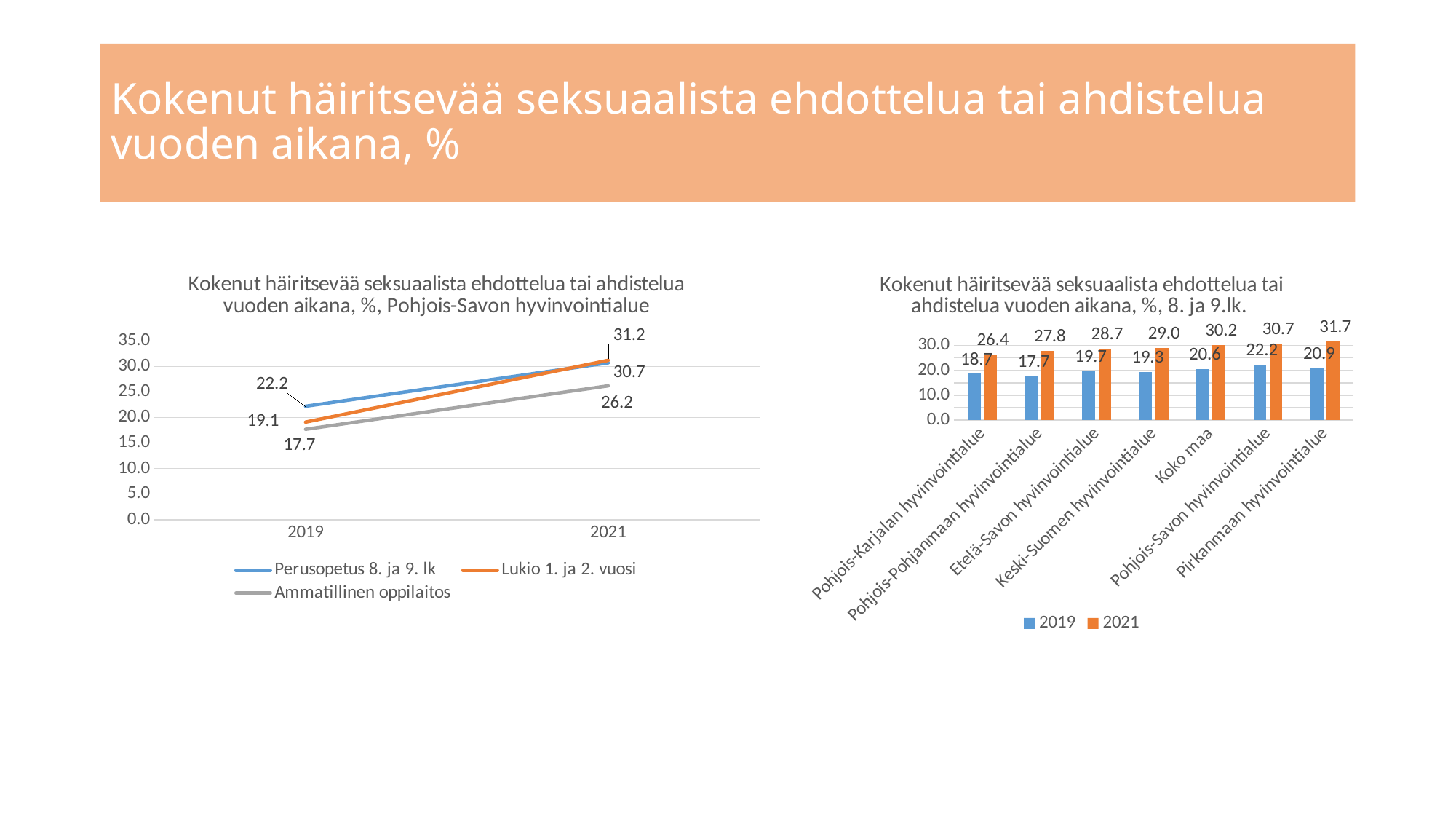
In the right chart (8. ja 9.lk), how many categories are shown on the x axis? 7 In the right chart (8. ja 9.lk), which category has the highest 2021 value? Pirkanmaan hyvinvointialue In the right chart (8. ja 9.lk), what is the 2021 value for Pirkanmaan hyvinvointialue? 31.7 In the left chart (Pohjois-Savon hyvinvointialue), do the values for Ammatillinen oppilaitos rise or fall from 2019 to 2021? Rise In the left chart (Pohjois-Savon hyvinvointialue), what is the value for Ammatillinen oppilaitos in 2021? 26.2 In the right chart (8. ja 9.lk), what is the 2019 value for Koko maa? 20.6 In the left chart (Pohjois-Savon hyvinvointialue), what is the value for Ammatillinen oppilaitos in 2019? 17.7 In the left chart (Pohjois-Savon hyvinvointialue), what kind of chart is it? Line chart In the left chart (Pohjois-Savon hyvinvointialue), what is the value for Perusopetus 8. ja 9. lk in 2019? 22.2 In the right chart (8. ja 9.lk), which category has the lowest 2019 value? Pohjois-Pohjanmaan hyvinvointialue In the right chart (8. ja 9.lk), what is the difference between the 2021 and 2019 values for Pohjois-Karjalan hyvinvointialue? 7.7 In the left chart (Pohjois-Savon hyvinvointialue), how many series does the legend list? 3